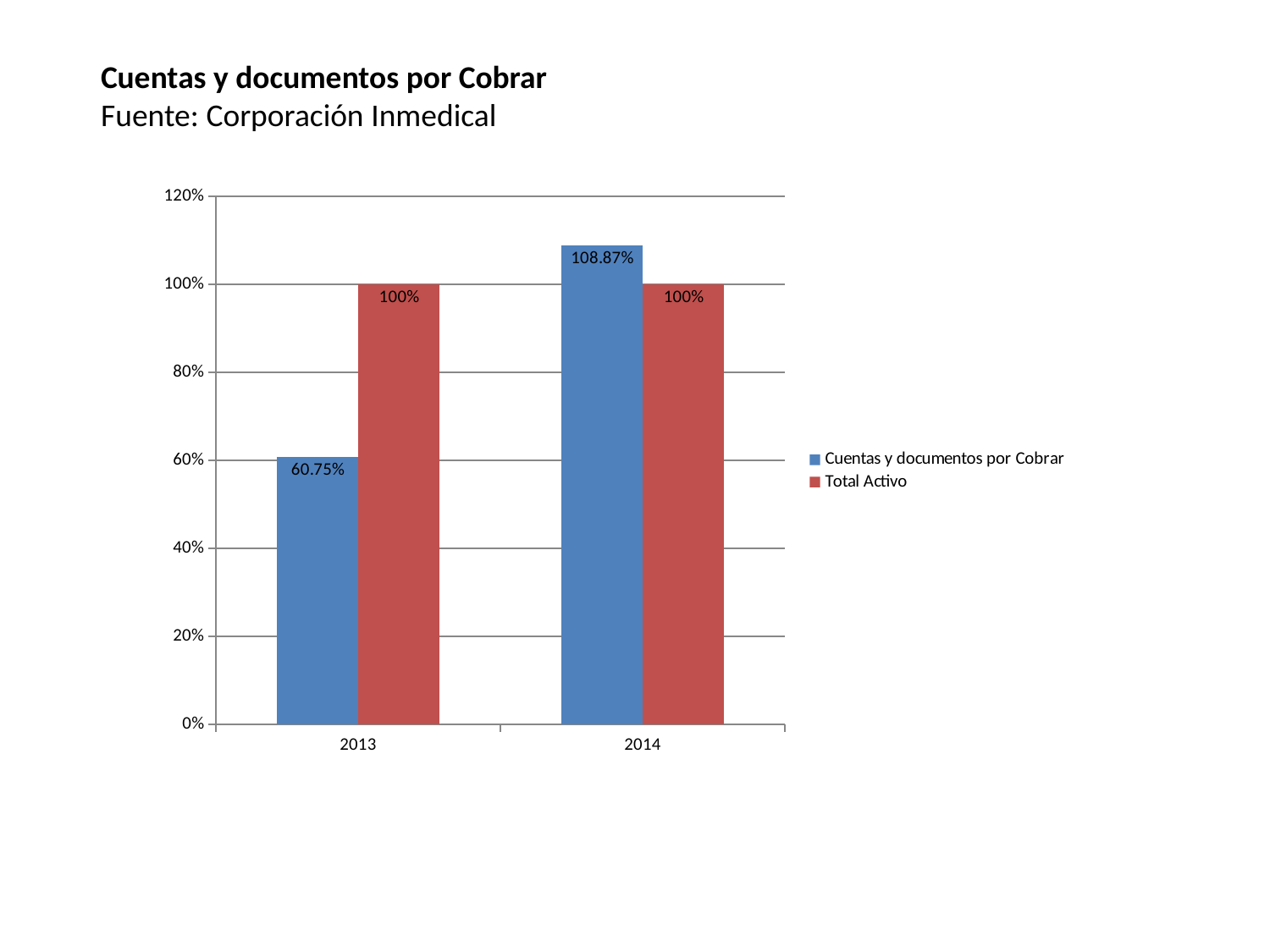
In which year is Cuentas y documentos por Cobrar lowest? 2013 In 2014, which is larger: Cuentas y documentos por Cobrar or Total Activo? Cuentas y documentos por Cobrar In which year is Cuentas y documentos por Cobrar highest? 2014 What is the value for Cuentas y documentos por Cobrar in 2013? 60.75% What is the value for Total Activo in 2013? 100% How many years are shown on the x axis? 2 What is the difference between Cuentas y documentos por Cobrar in 2014 and in 2013? 48.12% What kind of chart is shown on the slide? bar chart Does Cuentas y documentos por Cobrar rise or fall from 2013 to 2014? rise Is the value for Cuentas y documentos por Cobrar in 2013 greater or less than 80%? less What is the value for Cuentas y documentos por Cobrar in 2014? 108.87% How many series does the legend list? 2